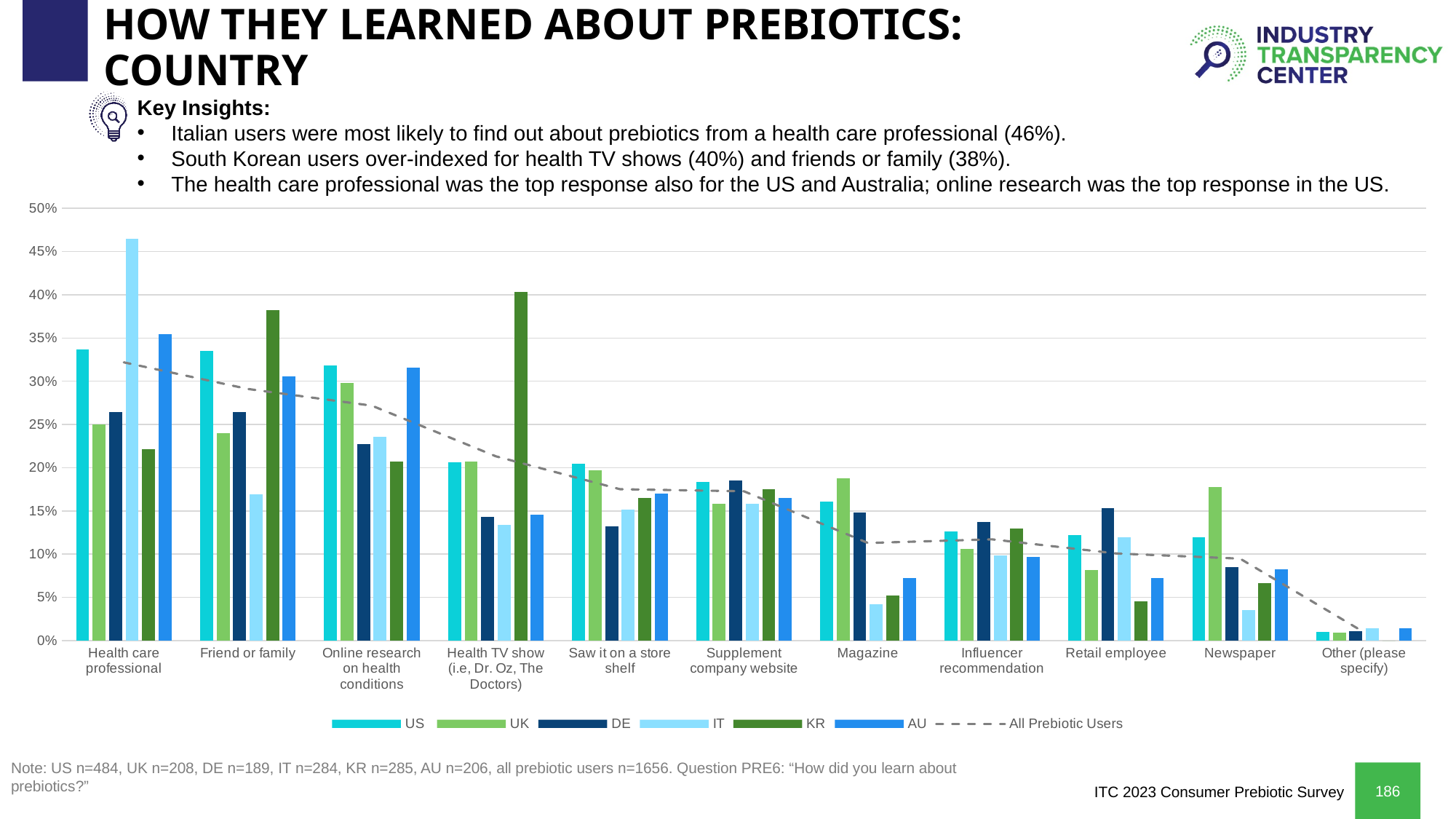
How many series does the legend list? 7 Is the value for UK under Newspaper greater or less than 15%? greater What kind of chart is shown on the slide? Combination bar and line chart Which country has the highest bar for Health TV show (i.e, Dr. Oz, The Doctors)? KR Does the dashed All Prebiotic Users line rise or fall from left to right across the categories? Fall Which country has the highest bar for Health care professional? IT How many response categories are shown along the x axis? 11 Which country has the lowest bar for Newspaper? IT Is the value for IT under Health care professional greater or less than 45%? greater Is the value for US under Health care professional greater or less than 35%? less Which country has the highest bar for Friend or family? KR For Supplement company website, which is larger, the DE bar or the IT bar? DE